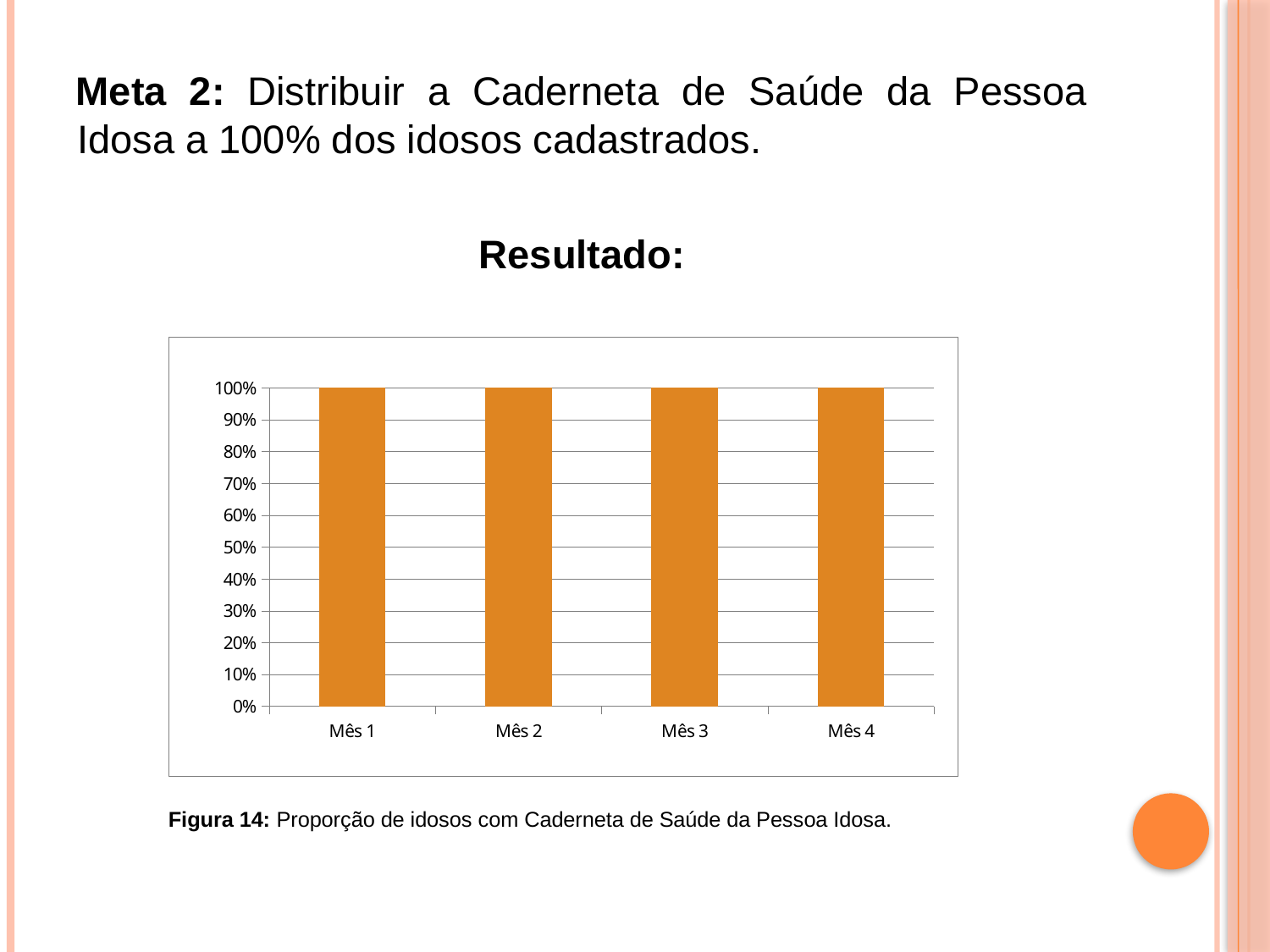
What is the value for Mês 1 in the chart? 100% Is the value for Mês 1 greater or less than 90%? greater What is the figure caption given below the chart? Figura 14: Proporção de idosos com Caderneta de Saúde da Pessoa Idosa. What colour are the bars in the chart? orange What is the value for Mês 4 in the chart? 100% What is the value for Mês 3 in the chart? 100% What is the difference between the values for Mês 4 and Mês 1? 0% Do the values rise, fall, or stay the same from Mês 1 to Mês 4? stay the same How many months (categories) are shown on the x axis of the chart? 4 What is the value for Mês 2 in the chart? 100% What kind of chart is shown on the slide? bar chart Is the value for Mês 3 greater or less than 50%? greater